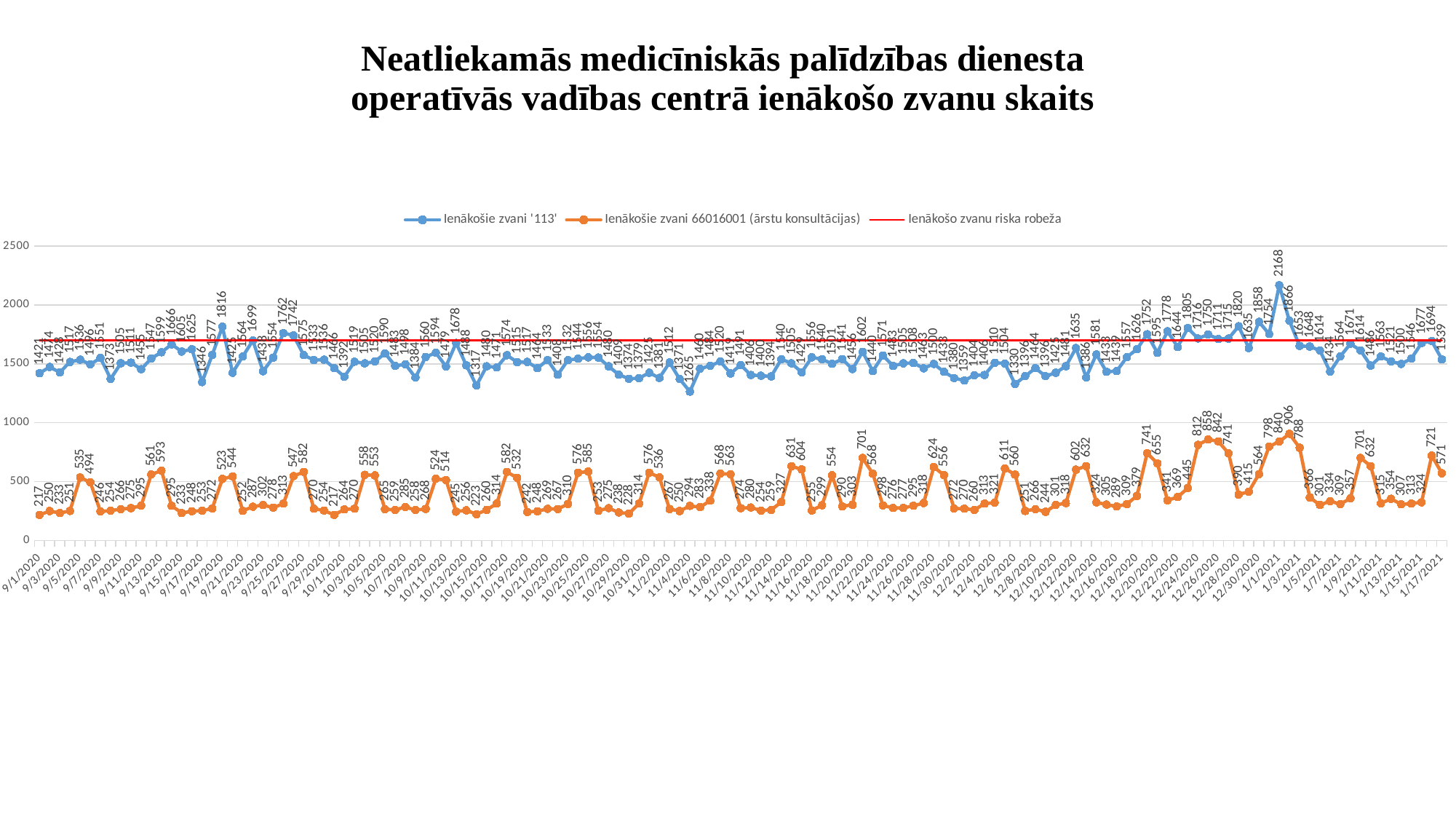
What is the name of the red line series in the legend? Ienākošo zvanu riska robeža What kind of chart is shown on the slide? line chart What is the highest value reached by the 'Ienākošie zvani '113'' series? 2168 What is the highest value reached by the 'Ienākošie zvani 66016001 (ārstu konsultācijas)' series? 906 Which series has consistently higher values, 'Ienākošie zvani '113'' or 'Ienākošie zvani 66016001 (ārstu konsultācijas)'? Ienākošie zvani '113' What is the lowest value of the 'Ienākošie zvani '113'' series? 1265 What is the value of the 'Ienākošie zvani 66016001 (ārstu konsultācijas)' series on 9/1/2020? 217 What is the lowest value of the 'Ienākošie zvani 66016001 (ārstu konsultācijas)' series? 217 How many series does the legend list? 3 Is the peak value of the 'Ienākošie zvani '113'' series greater or less than 2000? greater What is the difference between the peak of the '113' series (2168) and the peak of the 66016001 series (906)? 1262 Is the peak value of the 'Ienākošie zvani 66016001 (ārstu konsultācijas)' series greater or less than 1000? less